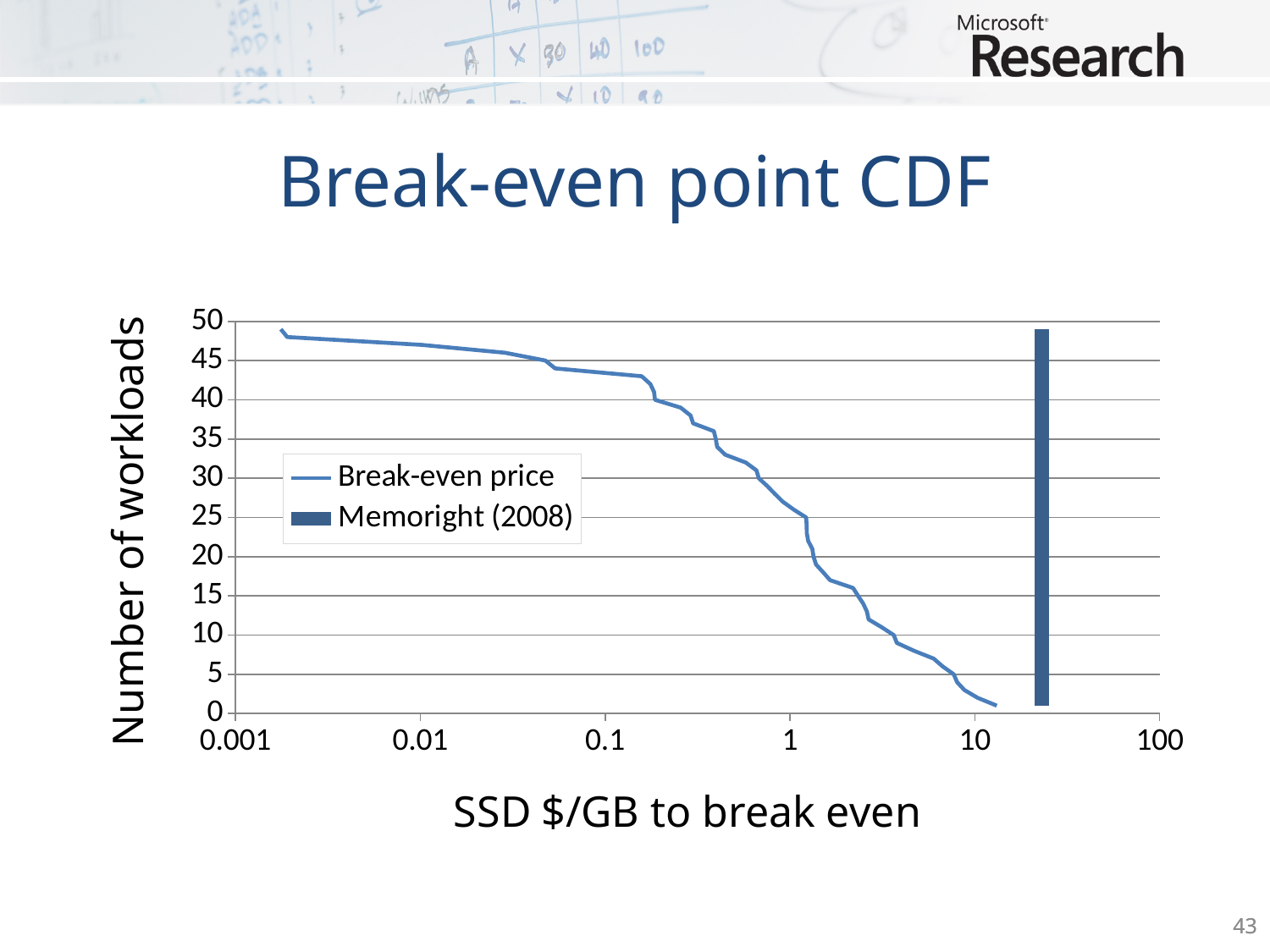
What is the title of the chart? Break-even point CDF Is the number of workloads on the Break-even price line at 0.01 $/GB greater or less than 45? greater Is the SSD $/GB position of the Memoright (2008) bar greater or less than 100? less What kind of chart is used to plot the Break-even price series? line chart Does the Break-even price line rise or fall as SSD $/GB increases along the x axis? fall Is the number of workloads on the Break-even price line at 10 $/GB greater or less than 5? less What is the label of the x axis? SSD $/GB to break even What is the highest tick value shown on the y axis? 50 How many series does the legend list? 2